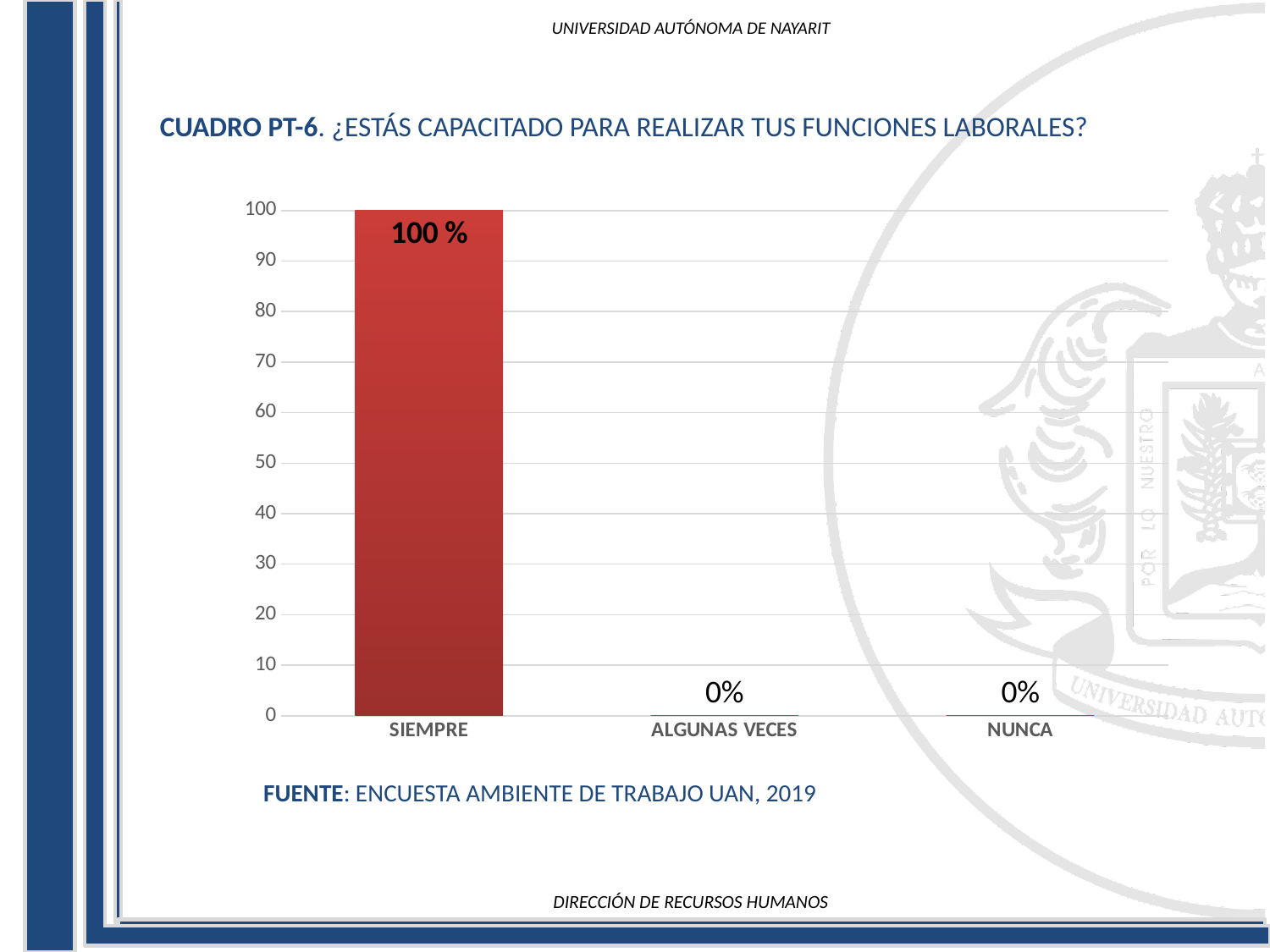
What colour is the bar for SIEMPRE? red What is the value for SIEMPRE? 100 % What is the difference between the values for SIEMPRE and NUNCA? 100 % What kind of chart is shown on the slide? bar chart What is the value for NUNCA? 0% Is the value for SIEMPRE greater or less than 50? greater Which is larger, the value for SIEMPRE or the value for ALGUNAS VECES? SIEMPRE Do the values rise or fall from SIEMPRE to NUNCA along the x axis? fall What is the title of the chart? CUADRO PT-6. ¿ESTÁS CAPACITADO PARA REALIZAR TUS FUNCIONES LABORALES? What is the value for ALGUNAS VECES? 0% Which category has the highest value? SIEMPRE How many categories are shown on the x axis? 3